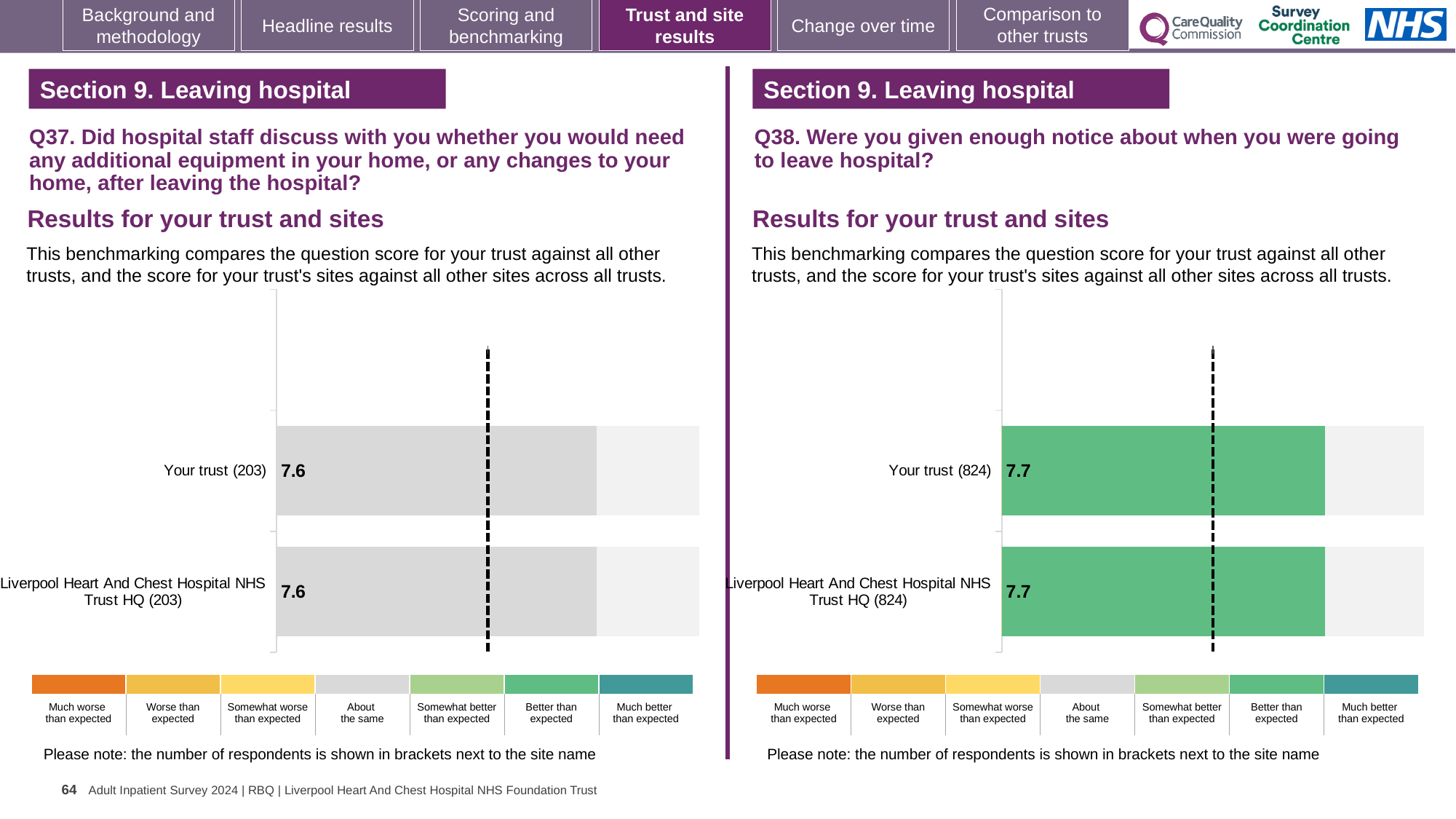
In the Q37 chart on the left, what is the difference between the score for Your trust and the score for Liverpool Heart And Chest Hospital NHS Trust HQ? 0 In the Q38 chart on the right, how many respondents are shown in brackets for Your trust? 824 In the Q38 chart on the right, what is the score for Liverpool Heart And Chest Hospital NHS Trust HQ? 7.7 In the Q38 chart on the right, how many bars are plotted? 2 In the Q38 chart on the right, what is the score for Your trust? 7.7 In the Q37 chart on the left, what is the score for Your trust? 7.6 What kind of chart is used in the Q37 chart on the left? Bar chart In the Q38 chart on the right, which benchmark category does the green colour of the bars correspond to according to the legend? Better than expected In the Q37 chart on the left, how many respondents are shown in brackets for Your trust? 203 In the Q37 chart on the left, which benchmark category does the grey colour of the bars correspond to according to the legend? About the same In the Q37 chart on the left, what is the score for Liverpool Heart And Chest Hospital NHS Trust HQ? 7.6 In the Q37 chart on the left, how many bars are plotted? 2